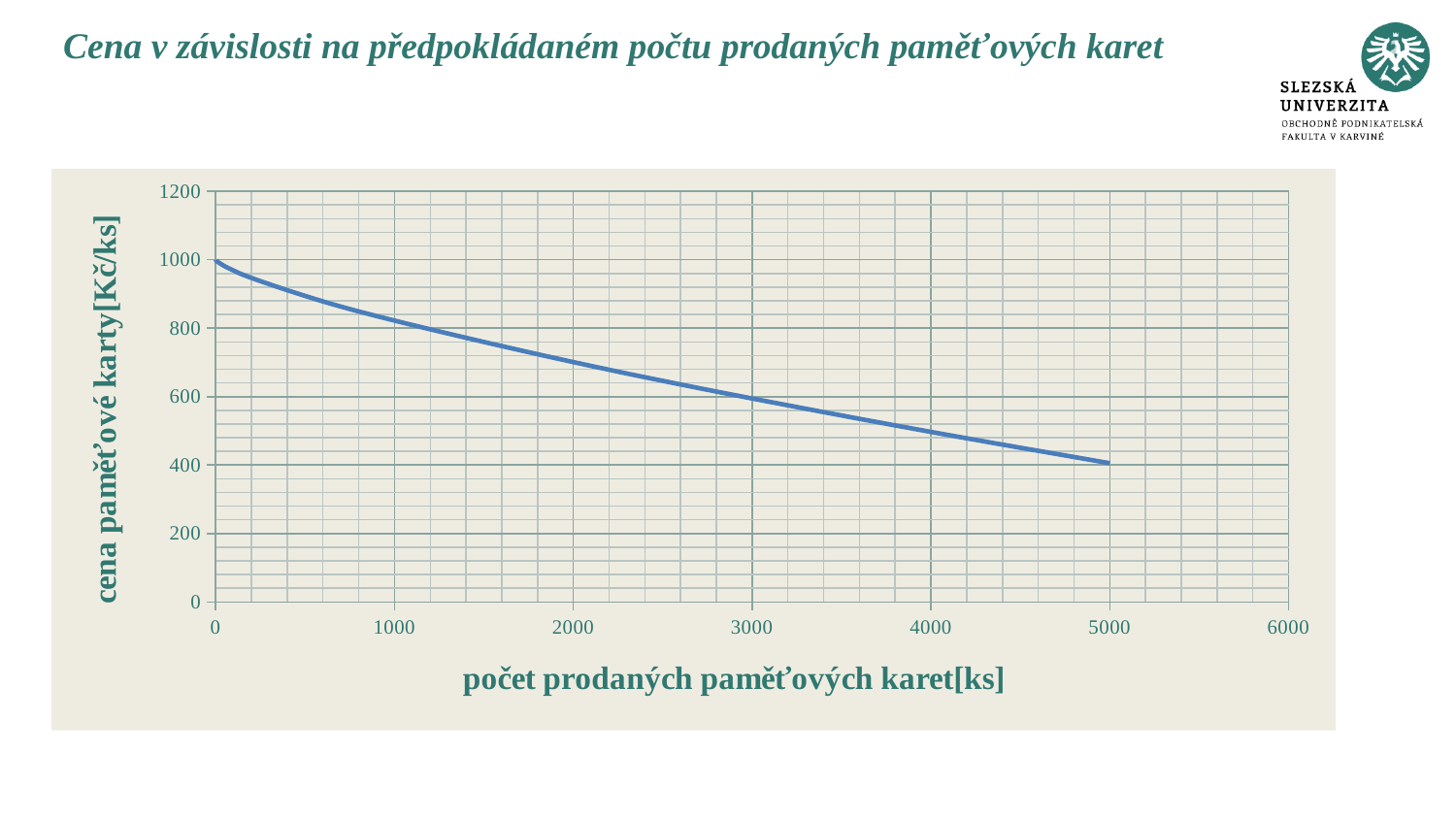
Is the price at 4000 sold memory cards greater or less than 400 Kč/ks? greater Is the price at 4000 sold memory cards greater or less than 600 Kč/ks? less Is the price at 0 sold memory cards greater or less than 800 Kč/ks? greater What is the label of the y axis? cena paměťové karty[Kč/ks] Does the price of a memory card rise or fall as the number of sold cards increases along the x axis? fall What is the label of the x axis? počet prodaných paměťových karet[ks] What kind of chart is shown on the slide? line chart Is the price at 1000 sold memory cards larger or smaller than the price at 3000 sold memory cards? larger